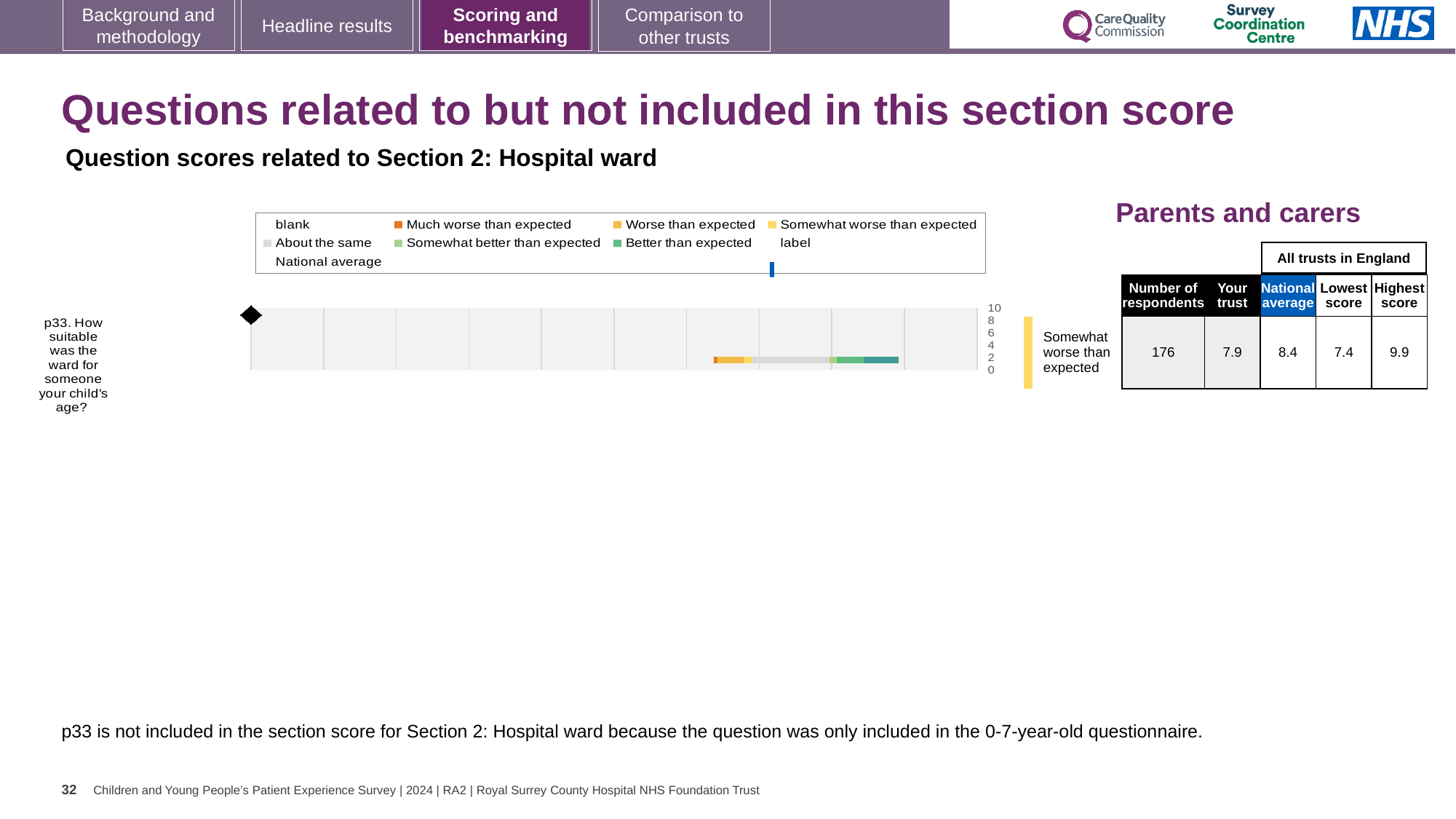
How many questions are plotted in the chart? 1 Which question is plotted in the chart? p33. How suitable was the ward for someone your child's age? What is the 'Your trust' score for p33 in the Parents and carers table? 7.9 How many respondents answered p33 according to the Parents and carers table? 176 What is the highest score among all trusts in England for p33? 9.9 By how much does the national average exceed the 'Your trust' score for p33? 0.5 What is the difference between the highest and lowest scores for p33 among all trusts in England? 2.5 What is the national average score for p33 in the Parents and carers table? 8.4 For p33, which is larger: the 'Your trust' score or the national average? National average What is the lowest score among all trusts in England for p33? 7.4 What type of chart is used to show the p33 question score? bar chart What benchmark category label is shown to the right of the p33 bar? Somewhat worse than expected